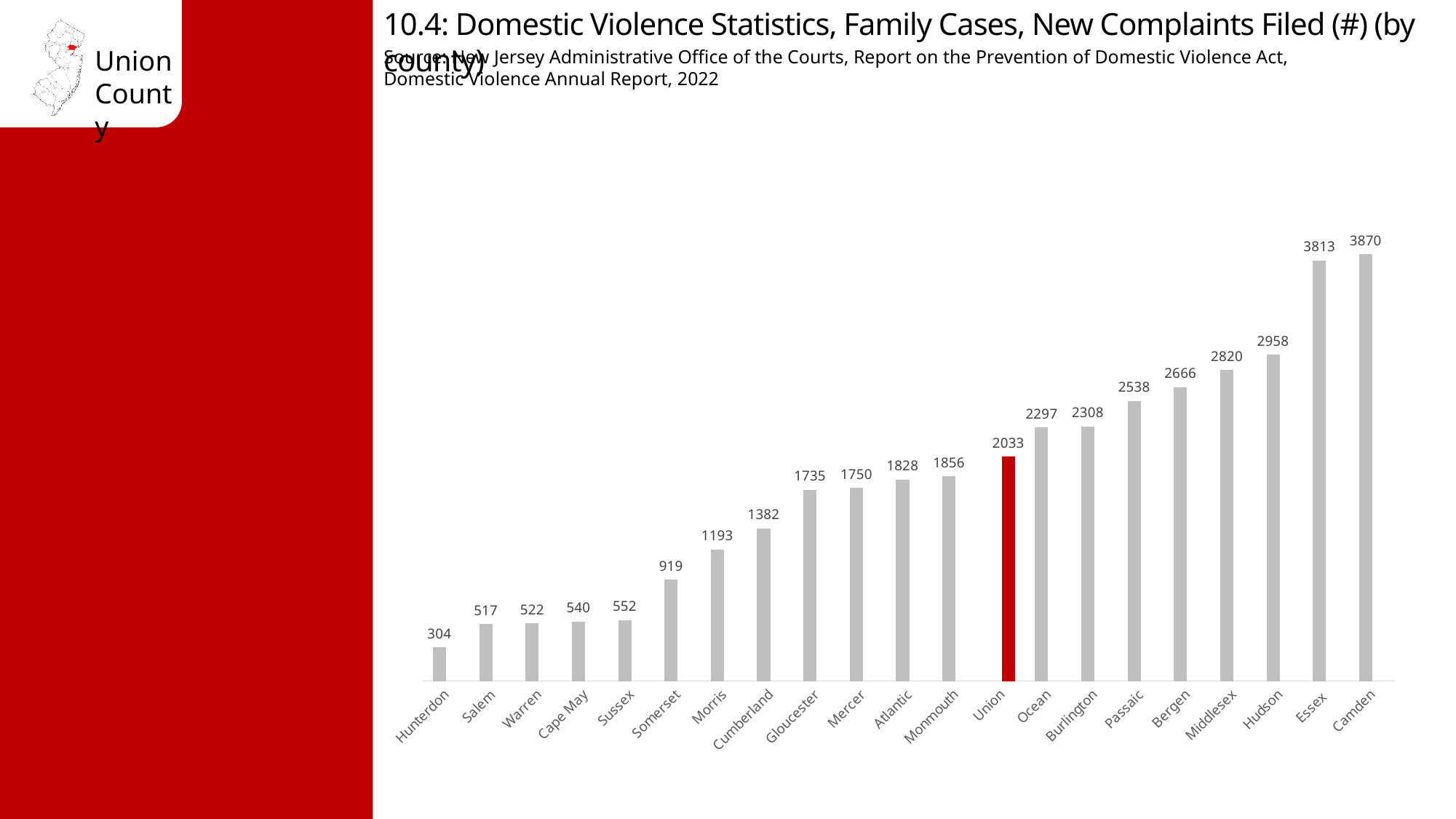
What is the difference between the values for Camden and Essex? 57 Which has a larger value, Hudson or Middlesex? Hudson Which county has the lowest number of new complaints filed? Hunterdon What is the difference between the values for Union and Hunterdon? 1729 Which has a larger value, Somerset or Morris? Morris Which county's bar is highlighted in red? Union What is the number of new domestic violence family case complaints filed for Union County? 2033 What kind of chart is shown on the slide? Bar chart What is the value shown for Passaic? 2538 Which county has the highest number of new complaints filed? Camden How many counties are shown on the chart? 21 What is the value shown for Hunterdon? 304